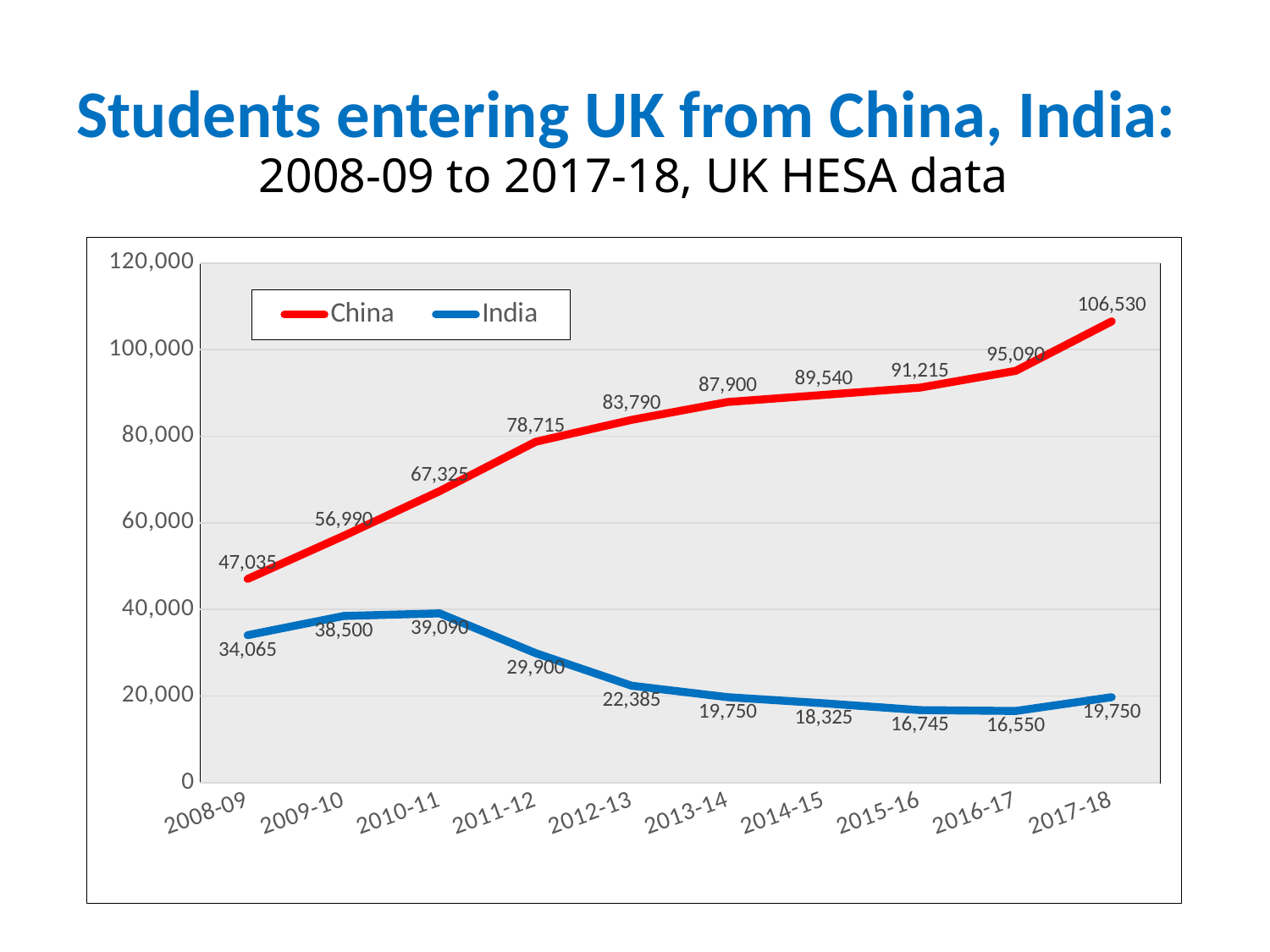
In which year is the value for India lowest? 2016-17 In which year is the value for China highest? 2017-18 Does the China series rise or fall from 2008-09 to 2017-18? rise What is the difference between the China and India values in 2017-18? 86,780 What kind of chart is shown on the slide? line chart What is the value for China in 2008-09? 47,035 How many series does the legend list? 2 What is the value for China in 2017-18? 106,530 How many years are shown on the x axis? 10 What is the value for India in 2010-11? 39,090 Is the value for China in 2011-12 greater or less than 80,000? less Which series has the larger value in 2012-13, China or India? China